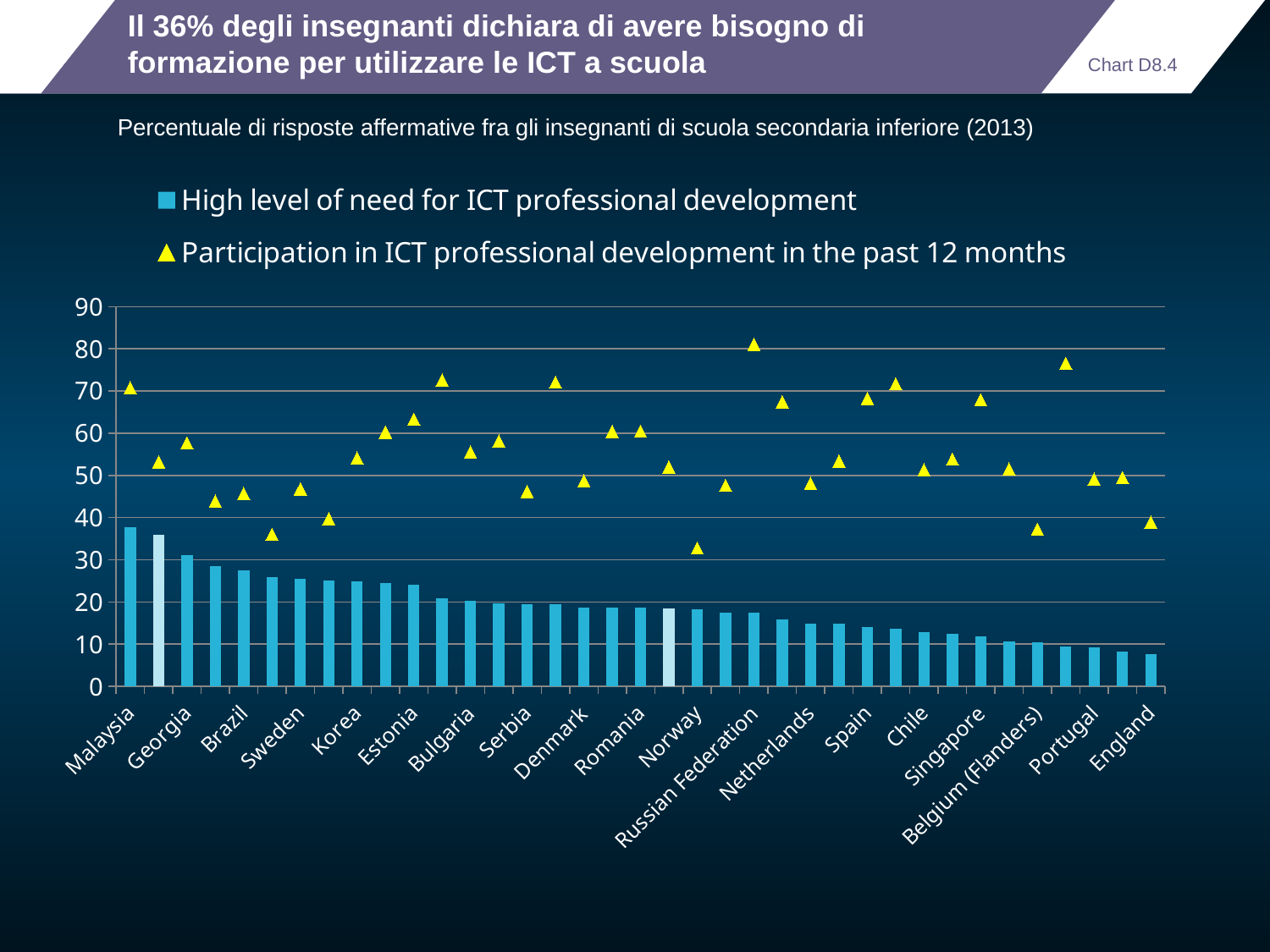
Is the 'Participation in ICT professional development in the past 12 months' value for Norway greater or less than 40? less Do the bars for 'High level of need for ICT professional development' rise or fall from left to right along the x axis? Fall How many series does the legend list? 2 Is the bar value for Malaysia greater or less than 30? greater Which labelled country has the lowest bar for 'High level of need for ICT professional development'? England Which country has the highest triangle marker for 'Participation in ICT professional development in the past 12 months'? Russian Federation Which country has the highest bar for 'High level of need for ICT professional development'? Malaysia What kind of chart is shown on the slide? A bar chart combined with triangle markers Which marker shape and colour represents 'Participation in ICT professional development in the past 12 months' in the legend? Yellow triangle Is the bar value for England greater or less than 10? less Which has the larger bar for 'High level of need for ICT professional development', Brazil or Portugal? Brazil